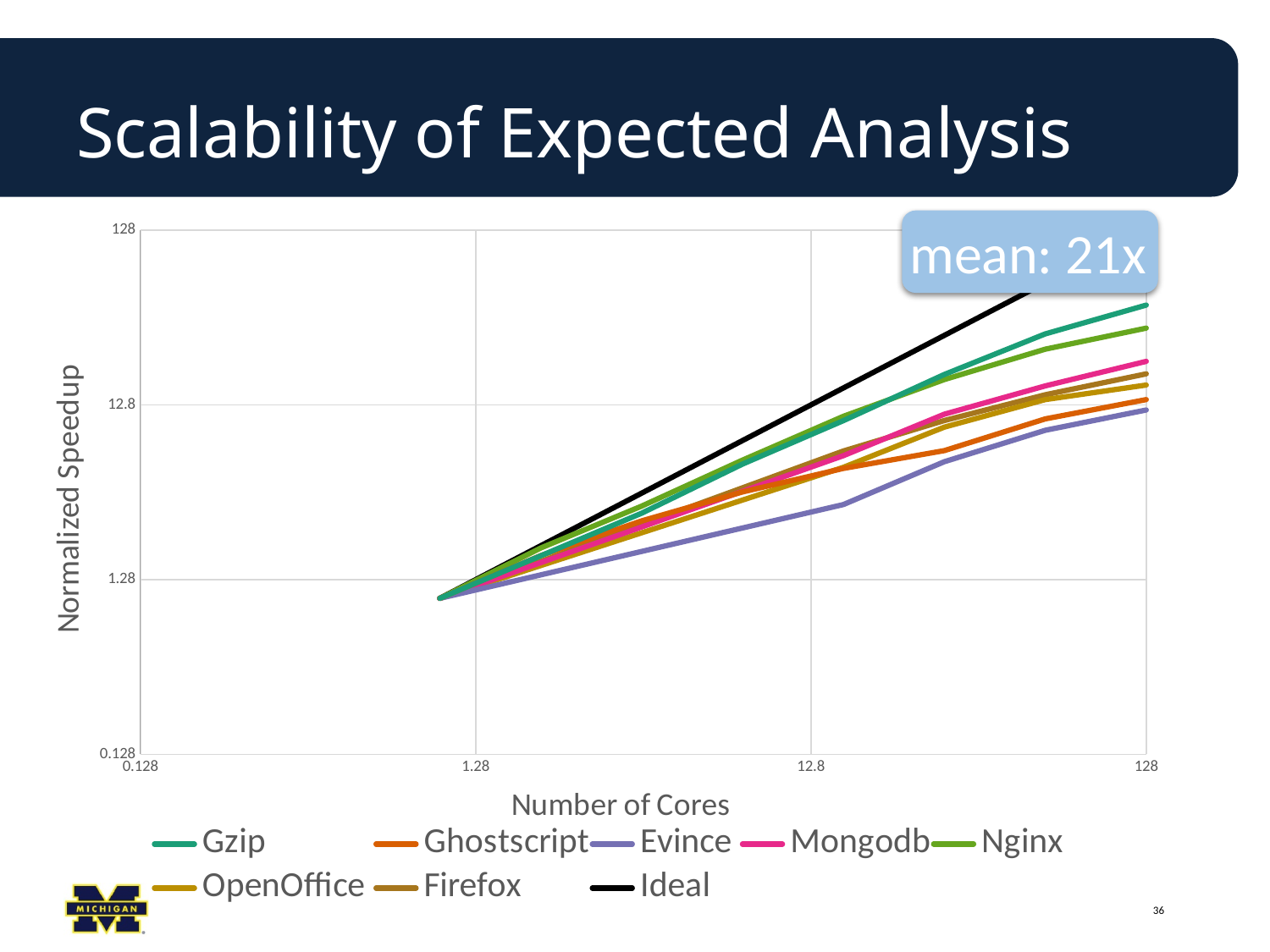
Do the normalized speedup values rise or fall as the number of cores increases? rise Which series has the lowest normalized speedup at 12.8 cores? Evince What is the label of the y axis? Normalized Speedup What is the title of the chart on the slide? Scalability of Expected Analysis Which series has the highest normalized speedup at 128 cores? Ideal How many series does the legend list? 8 At 128 cores, which has the larger normalized speedup, Gzip or Nginx? Gzip Is the normalized speedup for Gzip at 128 cores greater or less than 12.8? greater What is the highest tick value shown on the x axis? 128 Is the normalized speedup for Evince at 12.8 cores greater or less than 12.8? less What kind of chart is shown on the slide? line chart At 128 cores, which has the larger normalized speedup, Mongodb or Evince? Mongodb